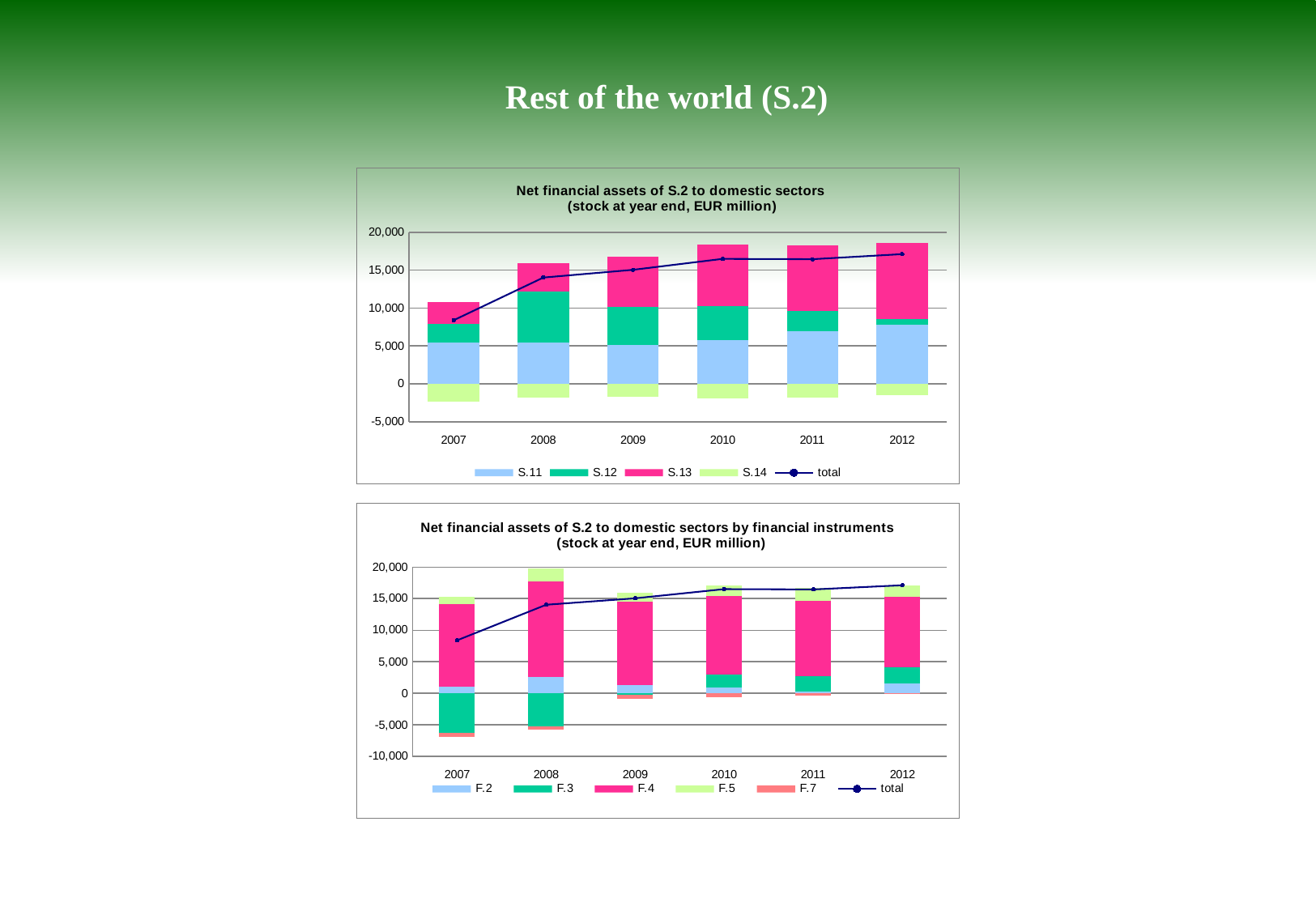
What unit is stated in the title of the top chart? EUR million In the top chart, which of the 'total' values is larger, 2008 or 2007? 2008 In the bottom chart, is the 'total' value for 2007 greater or less than 10,000? less In the top chart, is the 'total' value for 2007 greater or less than 10,000? less In the top chart, does the 'total' line generally rise or fall from 2007 to 2012? rise In the top chart, is the 'total' value for 2012 greater or less than 15,000? greater In the top chart, how many years are shown on the x axis? 6 What kind of chart is the top chart, 'Net financial assets of S.2 to domestic sectors'? Stacked bar chart with a line In the bottom chart, how many series does the legend list? 6 In the top chart, which year has the lowest value of the 'total' line? 2007 In the bottom chart, which series is shown in pink/magenta? F.4 In the top chart, how many series does the legend list? 5